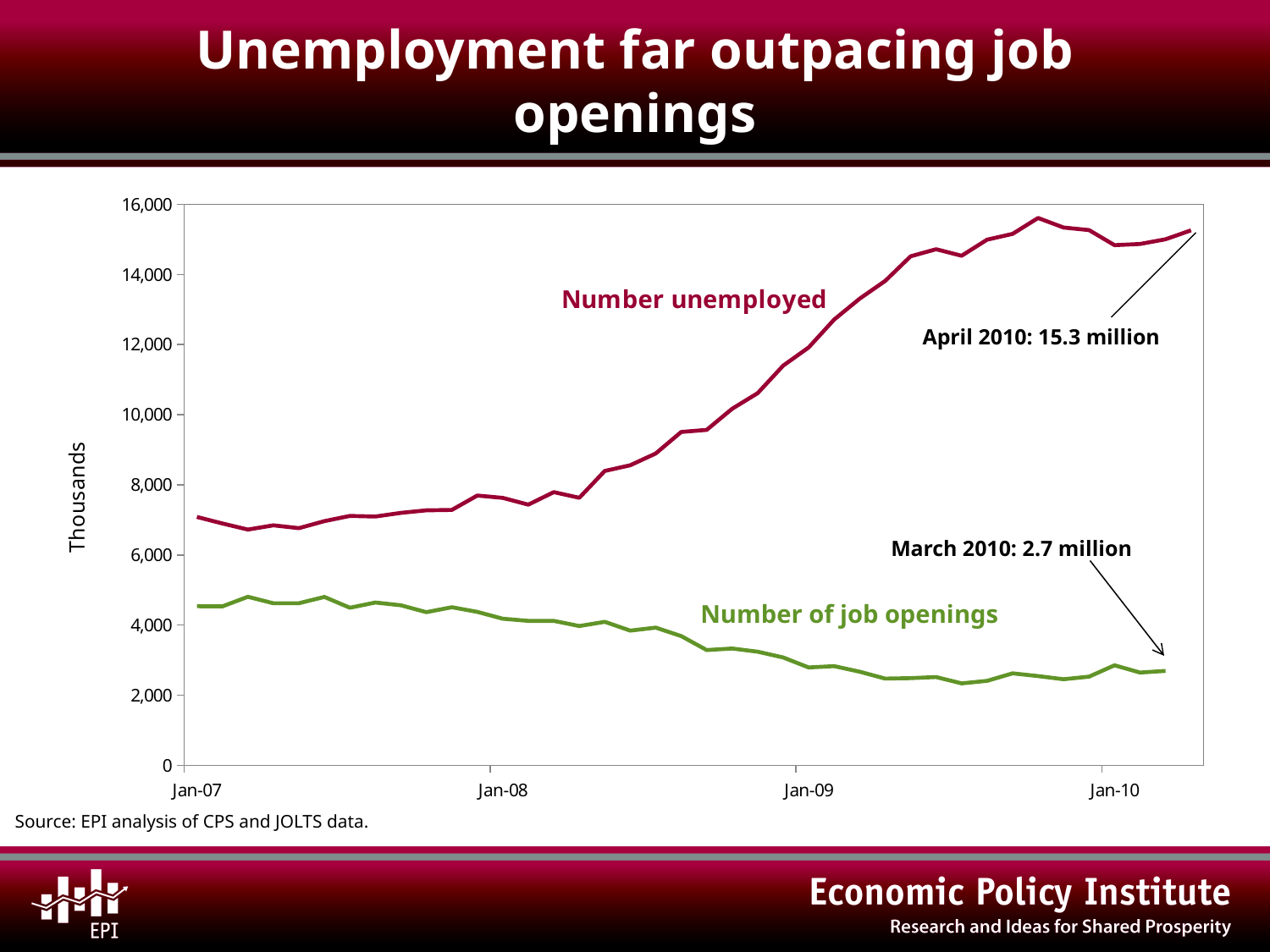
Is the number unemployed at Jan-07 greater or less than 8,000? less Does the number unemployed rise or fall between Jan-07 and Jan-10? Rise Is the number of job openings at Jan-09 greater or less than 4,000? less What value does the annotation give for the number unemployed in April 2010? 15.3 million Does the number of job openings rise or fall between Jan-07 and Jan-10? Fall What unit label is shown on the vertical axis? Thousands What is the title of the slide? Unemployment far outpacing job openings Which series is higher at Jan-10, number unemployed or number of job openings? Number unemployed How many data series are plotted on the chart? 2 What value does the annotation give for the number of job openings in March 2010? 2.7 million Is the number unemployed at Jan-09 greater or less than 10,000? greater What kind of chart is shown on the slide? Line chart